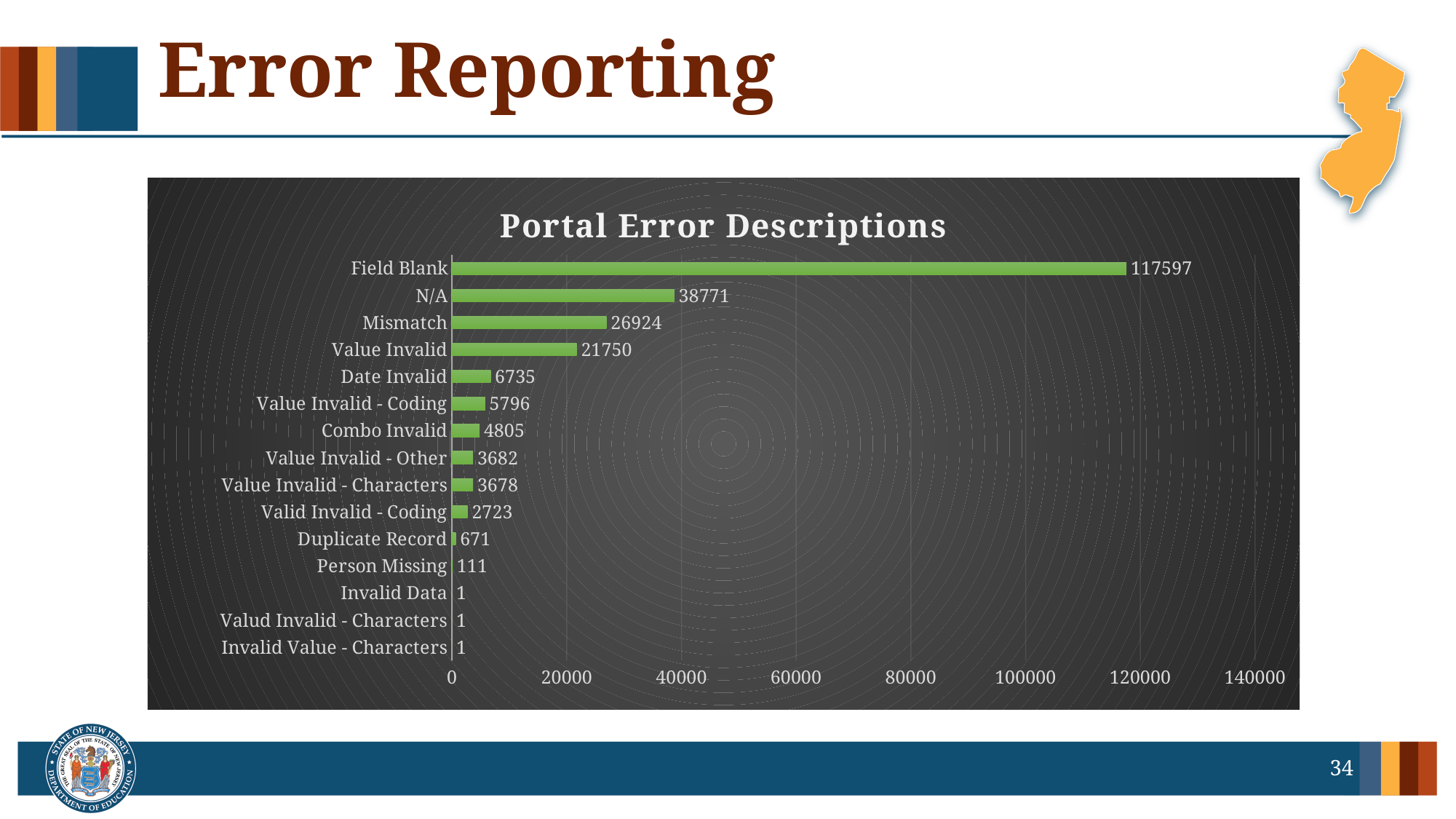
What is the title of the chart on the slide? Portal Error Descriptions Is the value for N/A in the Portal Error Descriptions chart greater or less than 40000? less Which category has the highest value in the Portal Error Descriptions chart? Field Blank What is the difference between the values for Field Blank and N/A in the Portal Error Descriptions chart? 78826 Which is larger in the Portal Error Descriptions chart, Date Invalid or Combo Invalid? Date Invalid What is the value for Field Blank in the Portal Error Descriptions chart? 117597 What is the difference between the values for Mismatch and Value Invalid in the Portal Error Descriptions chart? 5174 What is the value for Duplicate Record in the Portal Error Descriptions chart? 671 What kind of chart is the Portal Error Descriptions chart? Bar chart What is the value for Mismatch in the Portal Error Descriptions chart? 26924 How many categories are shown in the Portal Error Descriptions chart? 15 What is the value for Person Missing in the Portal Error Descriptions chart? 111